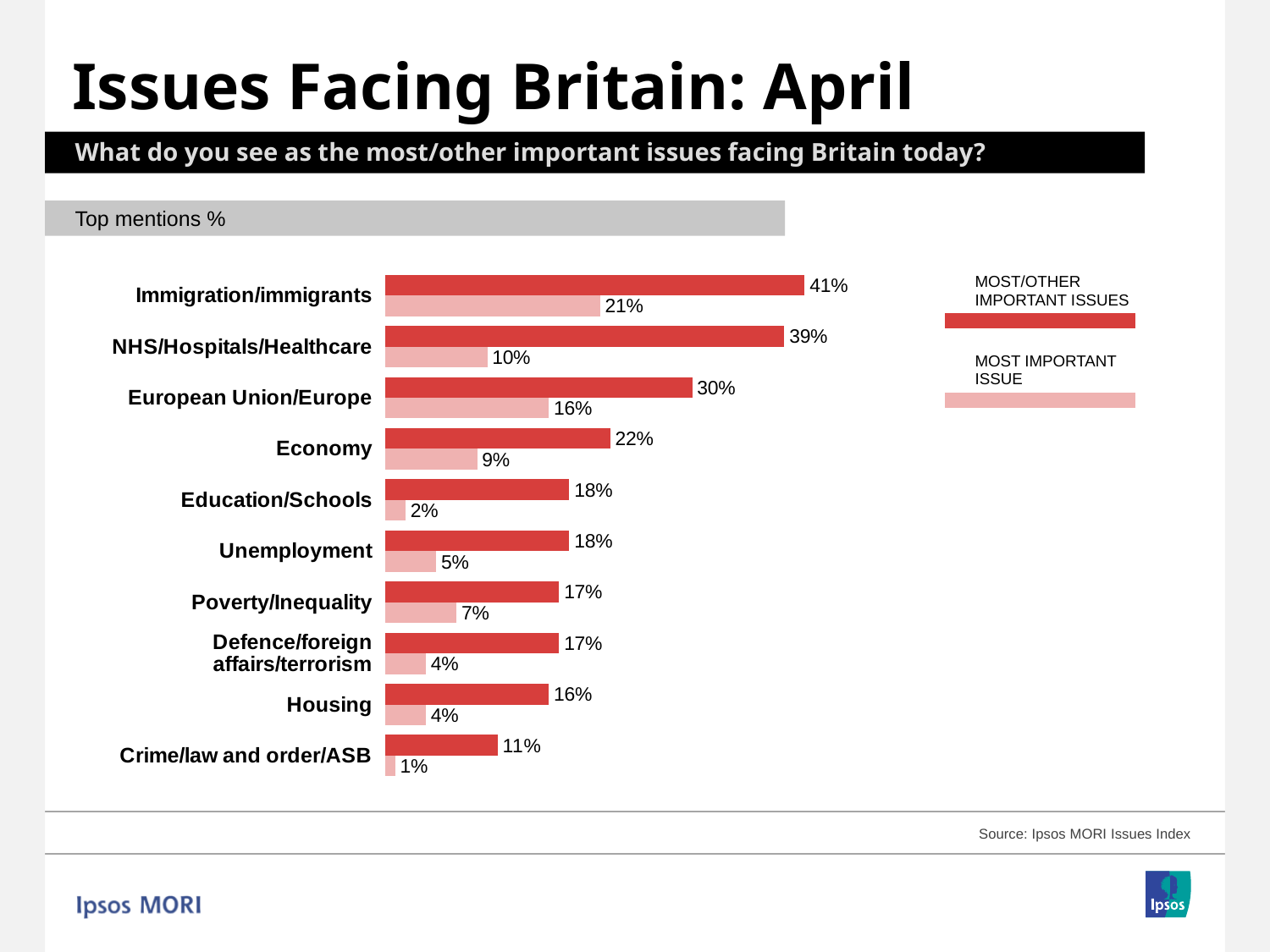
What percentage of respondents named Immigration/immigrants as a most/other important issue? 41% Which issue has the lowest most important issue percentage? Crime/law and order/ASB What kind of chart is shown on the slide? Bar chart Which issue has the highest most/other important issues percentage? Immigration/immigrants What percentage named NHS/Hospitals/Healthcare as the most important issue? 10% What is the difference between the most/other important issues value and the most important issue value for European Union/Europe? 14 percentage points How many series does the legend list? 2 Which has a higher most important issue percentage, Economy or Poverty/Inequality? Economy How many issues are listed in the chart? 10 Which series is shown in the lighter pink colour? MOST IMPORTANT ISSUE What is the difference between the most/other important issues values for Immigration/immigrants and NHS/Hospitals/Healthcare? 2 percentage points What is the most/other important issues value for Housing? 16%